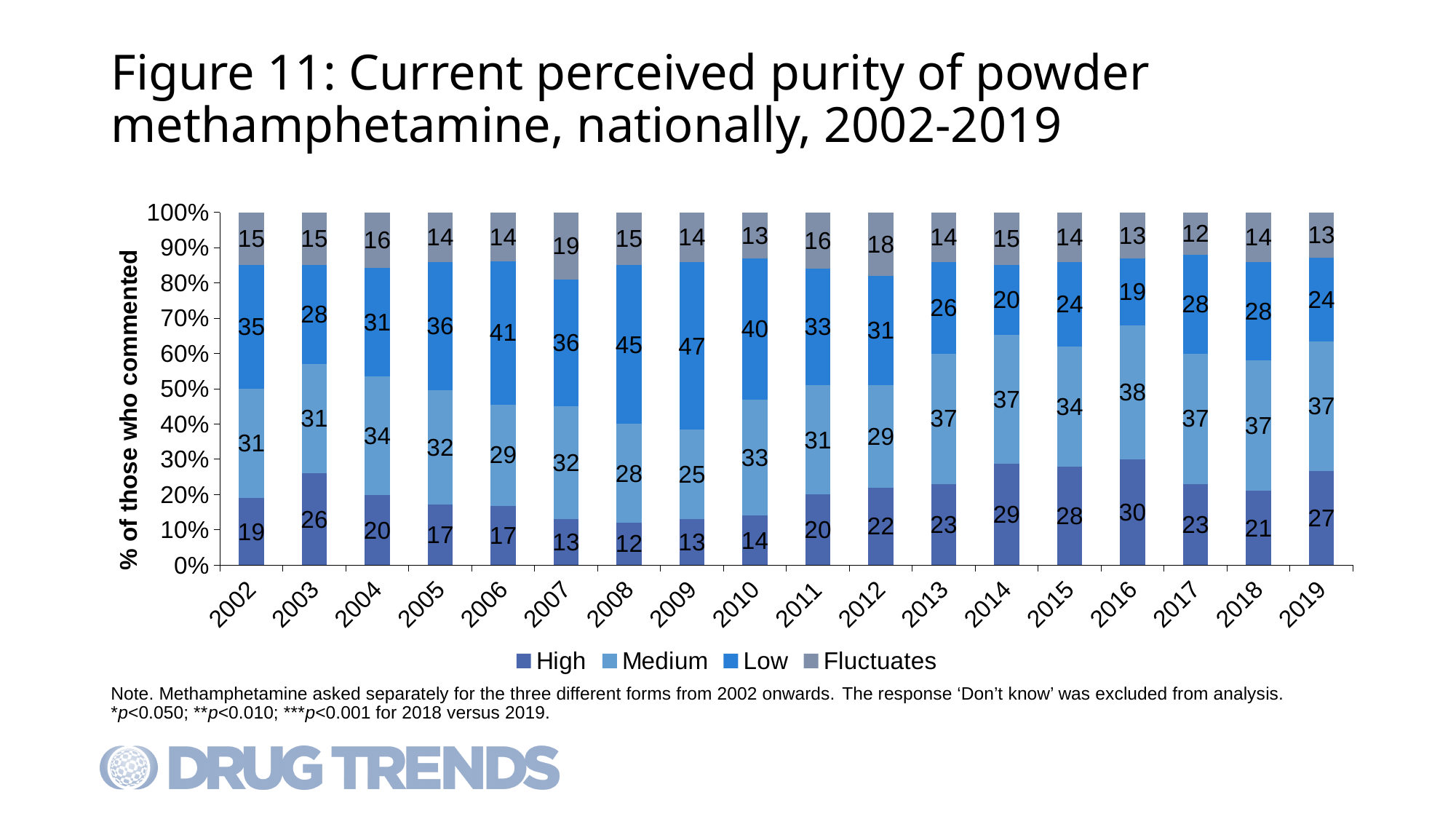
What is the difference between the Low value in 2009 and the Low value in 2016? 28 In which year is the High series at its lowest? 2008 What kind of chart is this? Stacked bar chart What is the value for High in 2016? 30 What is the value for Low in 2009? 47 What is the value for Fluctuates in 2007? 19 How many series does the legend list? 4 Which is larger, the High value in 2003 or the High value in 2014? 2014 How many years are shown on the x axis? 18 In which year is the Low series at its highest? 2009 What is the value for Medium in 2019? 37 In which year is the High series at its highest? 2016